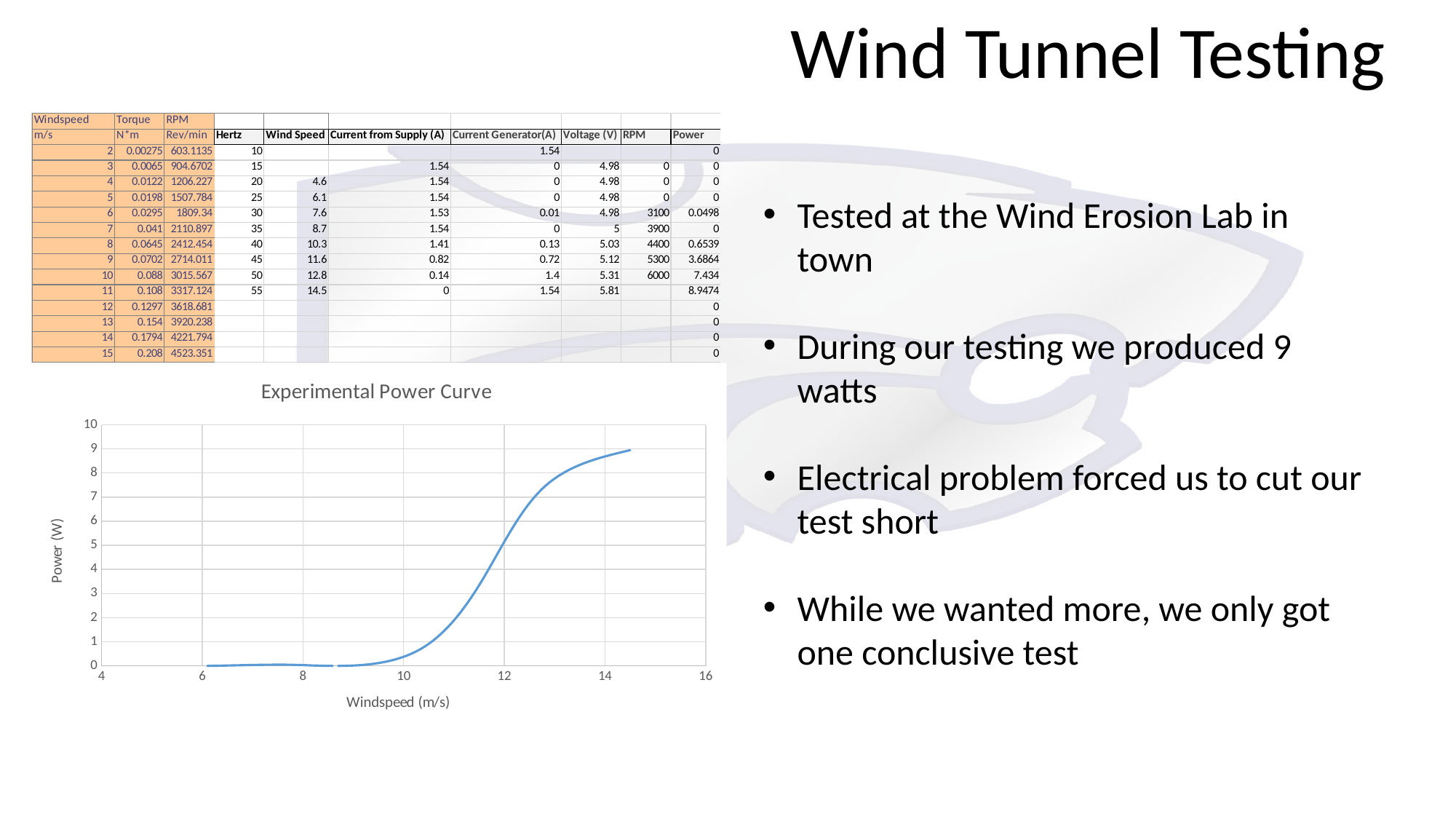
In the Experimental Power Curve chart, is the power at a windspeed of 12 m/s greater or less than 4? greater In the Experimental Power Curve chart, is the power at a windspeed of 8 m/s greater or less than 1? less What is the title of the chart on the slide? Experimental Power Curve What is the label of the y axis of the Experimental Power Curve chart? Power (W) In the Experimental Power Curve chart, is the power at a windspeed of 10 m/s greater or less than 3? less What kind of chart is the Experimental Power Curve? line chart In the Experimental Power Curve chart, is the power higher at a windspeed of 14 m/s or at 10 m/s? 14 m/s In the Experimental Power Curve chart, does the power rise or fall as windspeed increases? rises